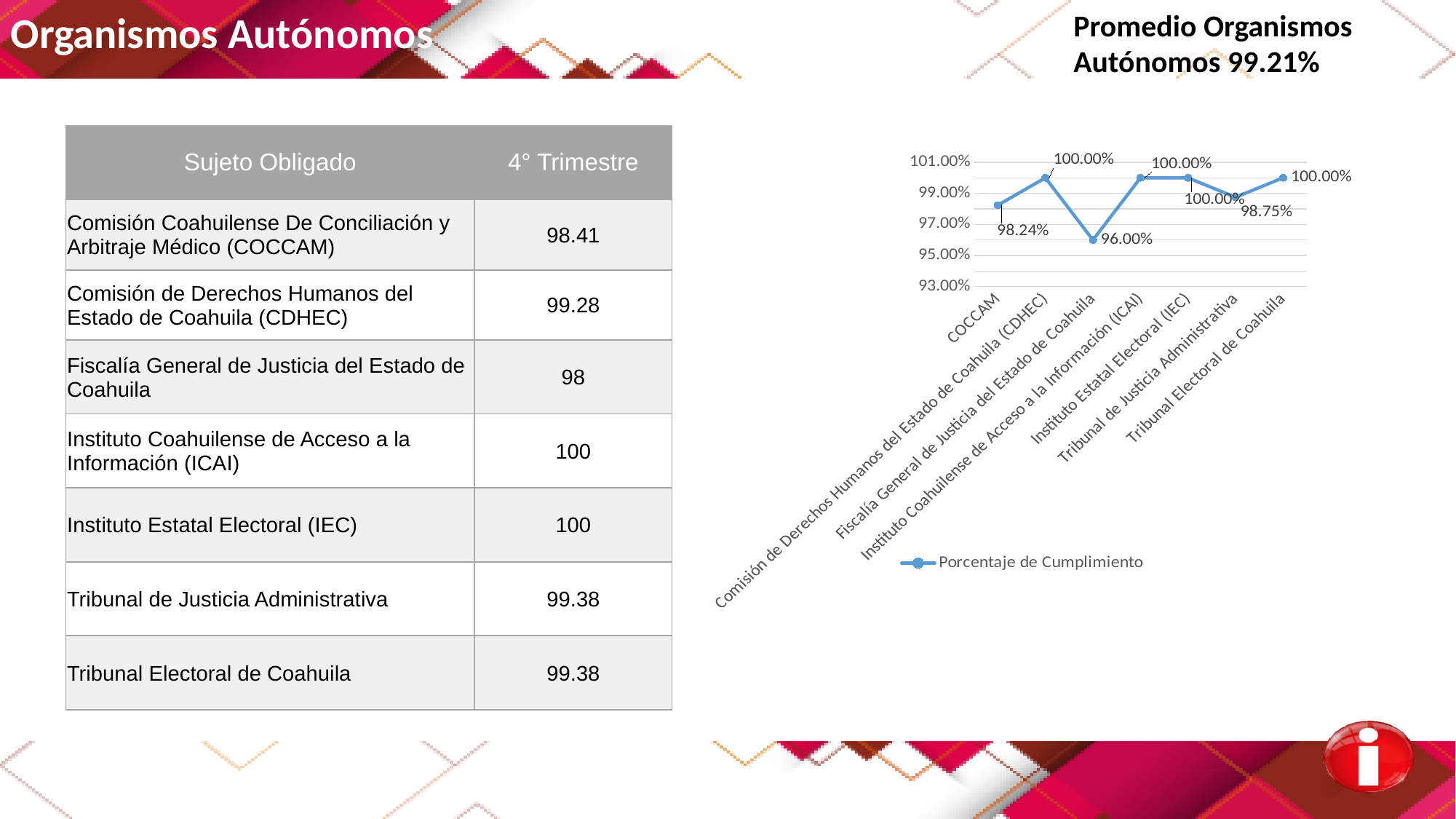
Which category has the lowest value in the chart? Fiscalía General de Justicia del Estado de Coahuila Which is larger in the chart, the value for COCCAM or the value for Tribunal de Justicia Administrativa? Tribunal de Justicia Administrativa How many series does the chart legend list? 1 How many categories are plotted on the x axis of the chart? 7 What is the Porcentaje de Cumplimiento value for Tribunal de Justicia Administrativa in the chart? 98.75% What is the Porcentaje de Cumplimiento value for COCCAM in the chart? 98.24% What type of chart is shown on the slide? line chart What is the difference between the chart values for COCCAM and Fiscalía General de Justicia del Estado de Coahuila? 2.24% What is the Porcentaje de Cumplimiento value for Tribunal Electoral de Coahuila in the chart? 100.00% Is the value for Fiscalía General de Justicia del Estado de Coahuila in the chart greater or less than 97.00%? less What is the name of the series shown in the chart legend? Porcentaje de Cumplimiento What is the Porcentaje de Cumplimiento value for Fiscalía General de Justicia del Estado de Coahuila in the chart? 96.00%